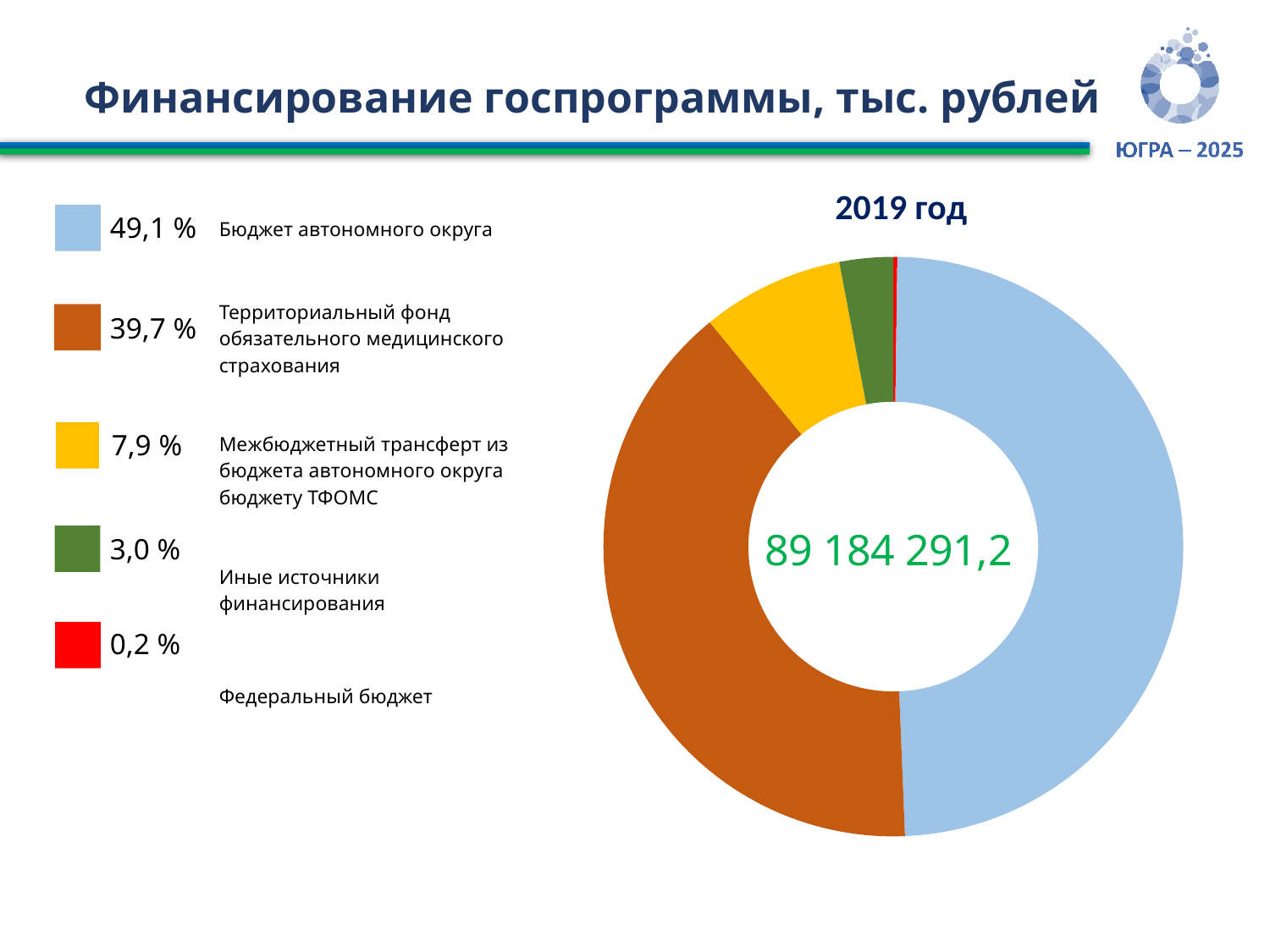
What share is shown for Федеральный бюджет? 0,2 % Which source has the largest share of the 2019 financing? Бюджет автономного округа Which year does the donut chart refer to? 2019 год Which source has the smallest share of the 2019 financing? Федеральный бюджет What is the difference in percentage points between Бюджет автономного округа and Территориальный фонд обязательного медицинского страхования? 9,4 What share of the 2019 financing comes from Бюджет автономного округа? 49,1 % What total value is printed in the centre of the donut chart? 89 184 291,2 What kind of chart is shown on the slide? Pie (donut) chart Which is larger: the share for Иные источники финансирования or the share for Межбюджетный трансферт? Межбюджетный трансферт How many slices does the donut chart have? 5 What share is shown for Межбюджетный трансферт из бюджета автономного округа бюджету ТФОМС? 7,9 % What share of the 2019 financing comes from Территориальный фонд обязательного медицинского страхования? 39,7 %